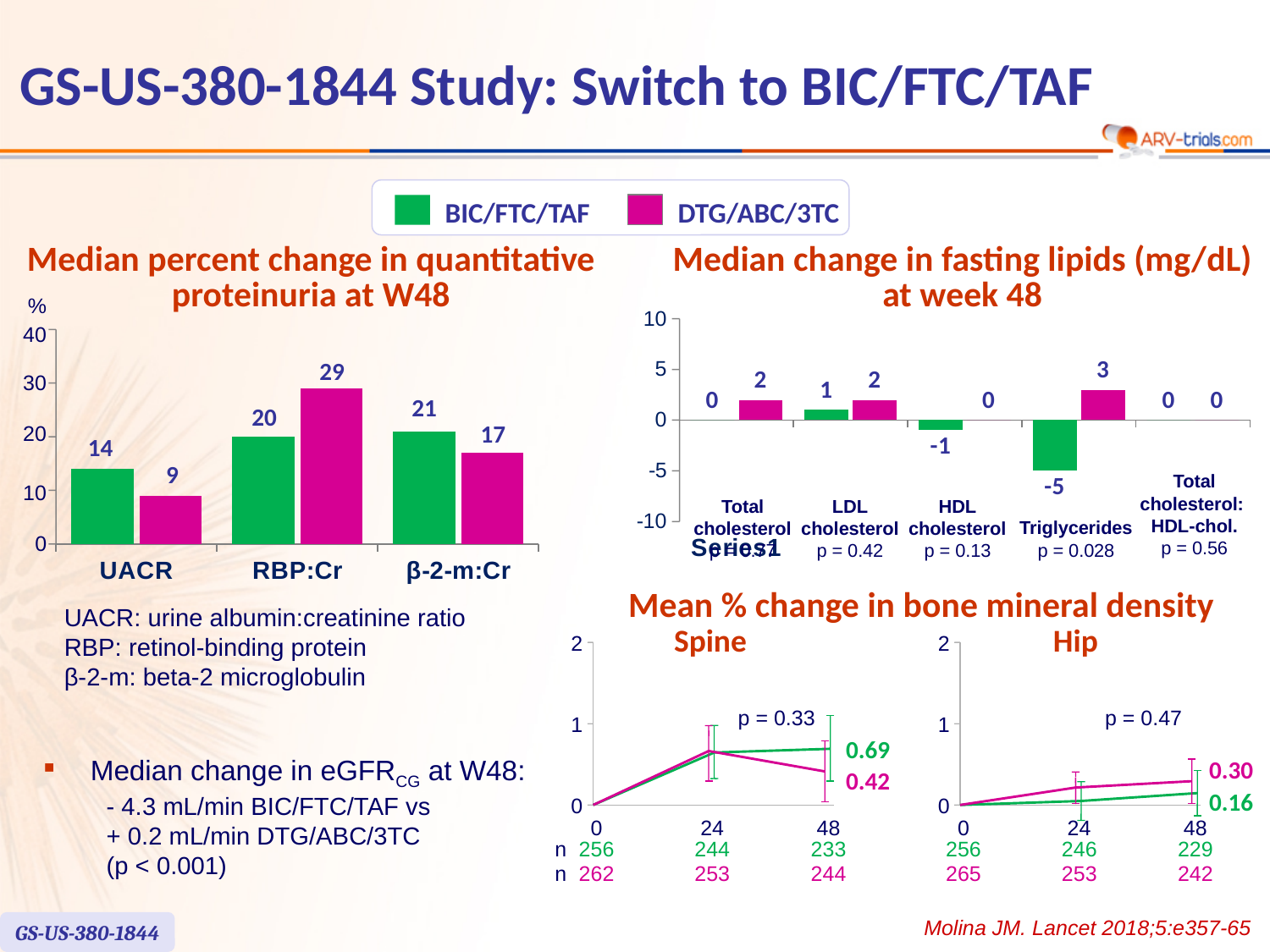
In the Hip bone mineral density chart, which series has the larger value at week 48? DTG/ABC/3TC In the 'Median change in fasting lipids (mg/dL) at week 48' chart, what is the DTG/ABC/3TC value for LDL cholesterol? 2 In the 'Median percent change in quantitative proteinuria at W48' chart, what is the value for DTG/ABC/3TC for RBP:Cr? 29 In the 'Median change in fasting lipids (mg/dL) at week 48' chart, which category has the lowest BIC/FTC/TAF value? Triglycerides What kind of chart is the 'Median percent change in quantitative proteinuria at W48' chart? bar chart In the 'Median percent change in quantitative proteinuria at W48' chart, what is the value for BIC/FTC/TAF for UACR? 14 In the 'Median percent change in quantitative proteinuria at W48' chart, which series has the larger value for β-2-m:Cr? BIC/FTC/TAF How many categories are shown in the 'Median percent change in quantitative proteinuria at W48' chart? 3 In the Spine bone mineral density chart, what is the BIC/FTC/TAF value at week 48? 0.69 In the 'Median percent change in quantitative proteinuria at W48' chart, which category has the highest DTG/ABC/3TC value? RBP:Cr In the 'Median percent change in quantitative proteinuria at W48' chart, what is the difference between the DTG/ABC/3TC and BIC/FTC/TAF values for RBP:Cr? 9 In the 'Median change in fasting lipids (mg/dL) at week 48' chart, what is the BIC/FTC/TAF value for Triglycerides? -5